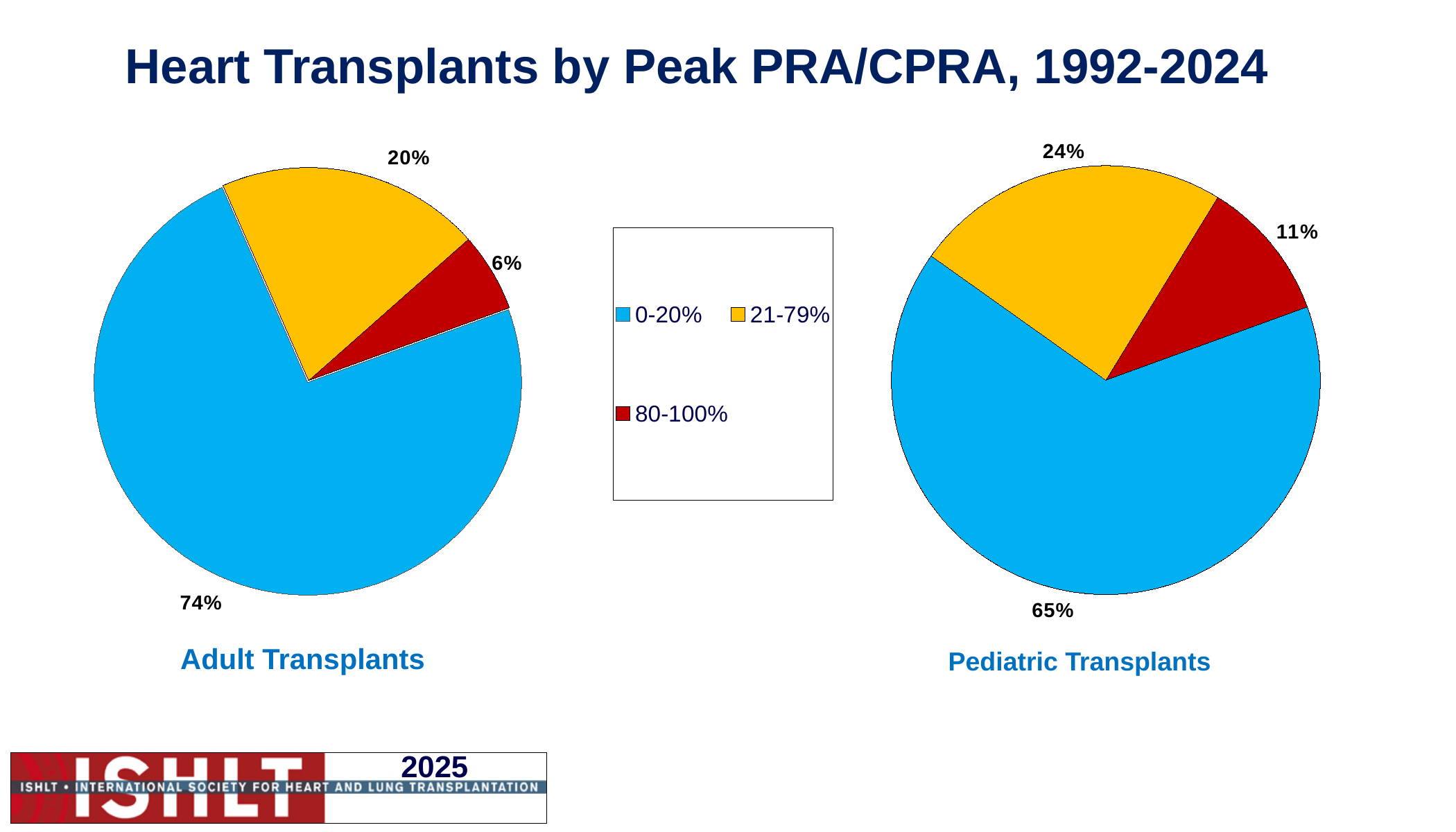
In the Adult Transplants pie chart, which peak PRA/CPRA category has the largest share? 0-20% In the Pediatric Transplants pie chart, what share is labelled for the 21-79% category? 24% In the Pediatric Transplants pie chart, what share of heart transplants had a peak PRA/CPRA of 80-100%? 11% How many categories does the legend list? 3 What is the difference between the 0-20% share in the Adult Transplants pie chart and the 0-20% share in the Pediatric Transplants pie chart? 9 percentage points What type of chart is used for the Pediatric Transplants data? Pie chart How many slices does the Adult Transplants pie chart have? 3 In the Adult Transplants pie chart, what share is labelled for the 21-79% category? 20% Is the 80-100% share larger in the Adult Transplants pie chart or the Pediatric Transplants pie chart? Pediatric Transplants In the Adult Transplants pie chart, what share of heart transplants had a peak PRA/CPRA of 0-20%? 74% In the Pediatric Transplants pie chart, which peak PRA/CPRA category has the smallest share? 80-100% What colour represents the 80-100% peak PRA/CPRA category in the legend? Red